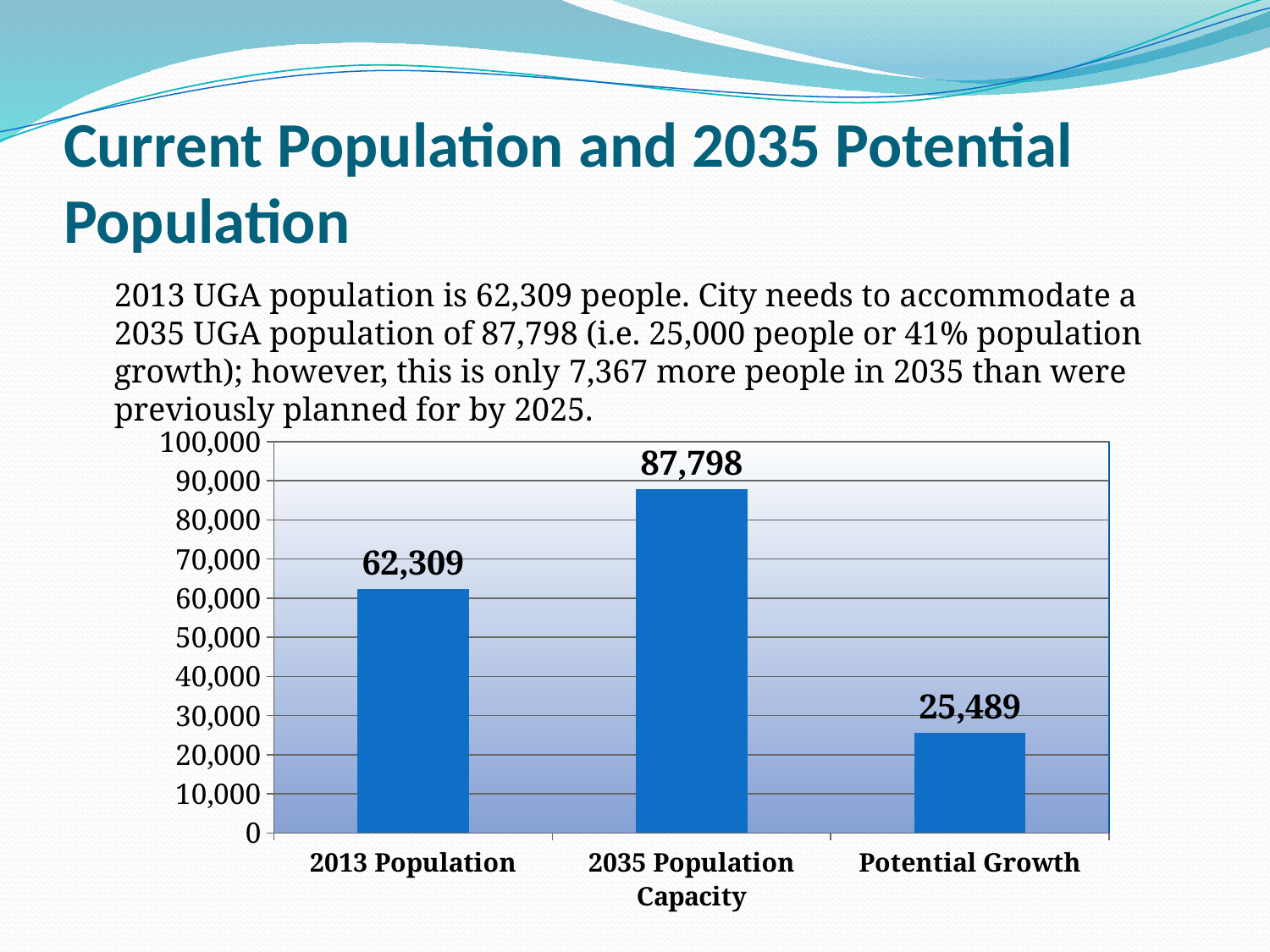
Is the value for 2013 Population greater or less than 60,000? greater Is the value for Potential Growth greater or less than 30,000? less Which is larger, 2013 Population or Potential Growth? 2013 Population What is the value for 2013 Population? 62,309 What is the difference between 2013 Population and Potential Growth? 36,820 How many categories are shown in the chart? 3 What is the difference between 2035 Population Capacity and 2013 Population? 25,489 Which category has the highest value? 2035 Population Capacity What is the value for Potential Growth? 25,489 What is the value for 2035 Population Capacity? 87,798 Which category has the lowest value? Potential Growth What kind of chart is shown on the slide? bar chart